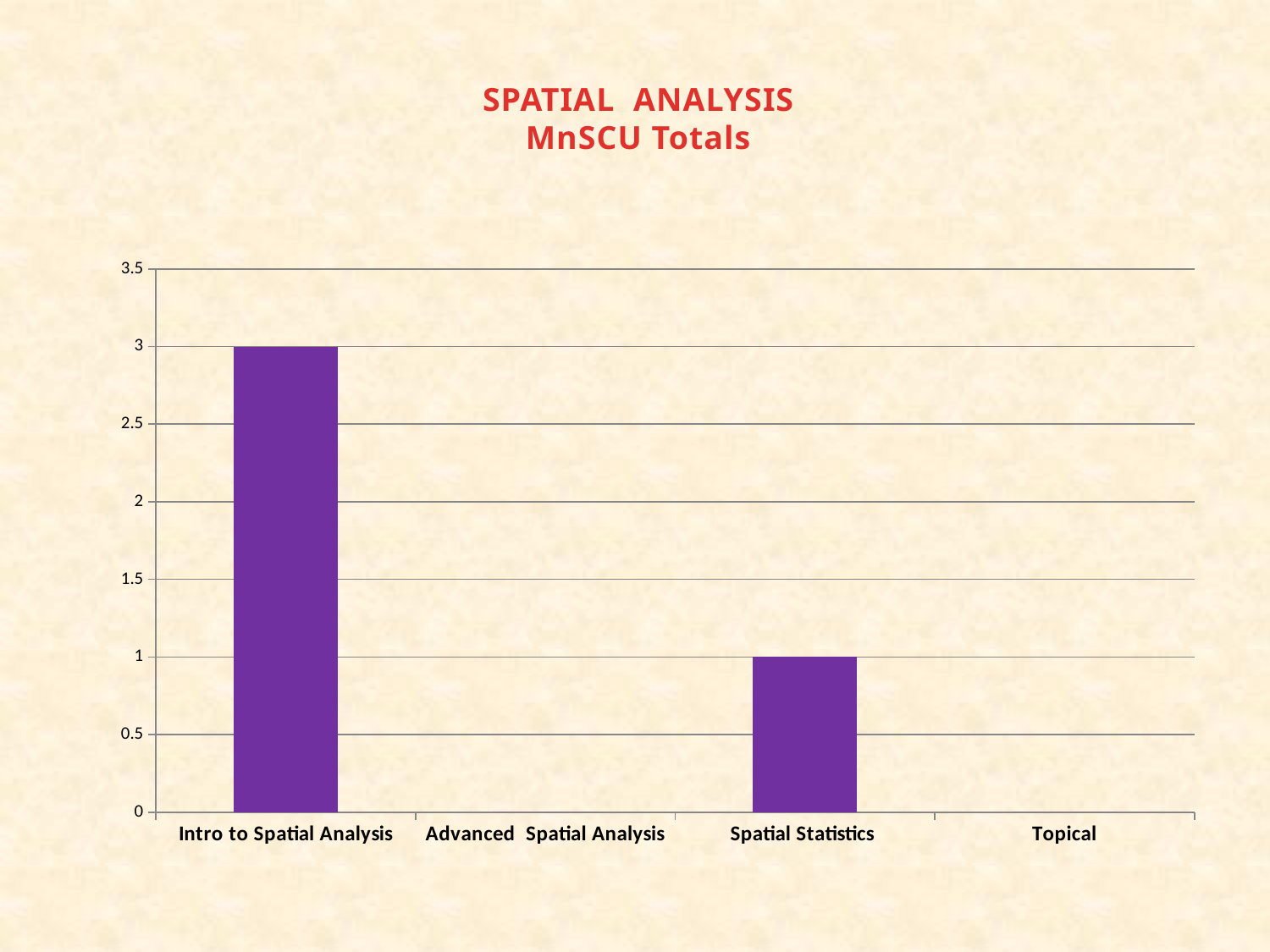
Which category has the highest value? Intro to Spatial Analysis What is the value for Topical? 0 What is the title of the chart? SPATIAL ANALYSIS MnSCU Totals What is the value for Spatial Statistics? 1 What is the value for Intro to Spatial Analysis? 3 Is the value for Intro to Spatial Analysis greater or less than 2? greater How many categories are shown on the x axis? 4 What is the difference between the values for Intro to Spatial Analysis and Spatial Statistics? 2 What is the value for Advanced Spatial Analysis? 0 What type of chart is shown on the slide? bar chart Is the value for Spatial Statistics greater or less than 2? less Which is larger, the value for Intro to Spatial Analysis or the value for Spatial Statistics? Intro to Spatial Analysis